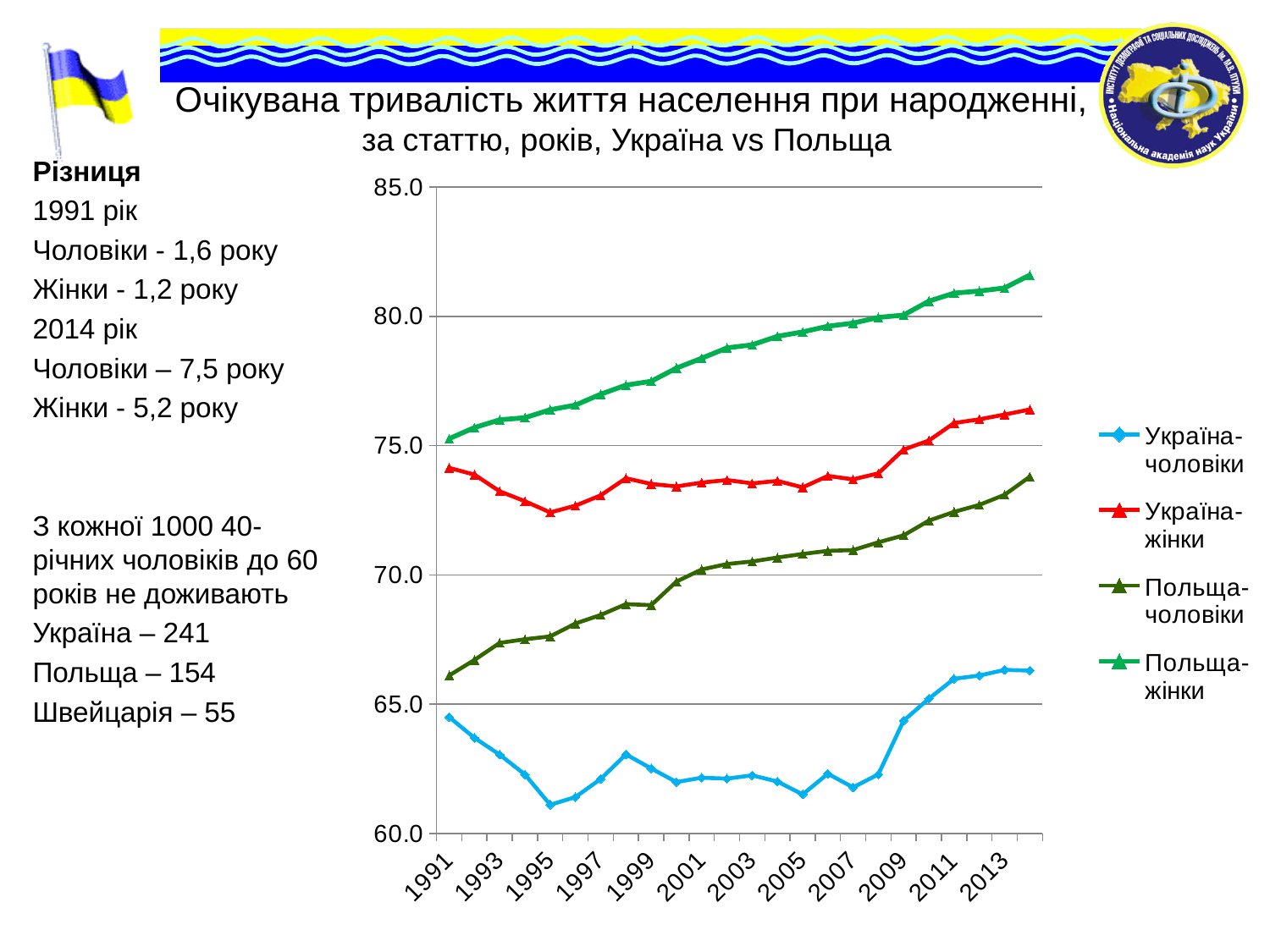
Is the value for Польща-жінки in 2013 greater or less than 80.0? greater Is the value for Україна-чоловіки in 1995 greater or less than 65.0? less Which series has the highest values throughout the chart? Польща-жінки Which series has the lowest values throughout the chart? Україна-чоловіки How many year labels are shown on the x axis? 12 In 2005, which is larger: the value for Україна-чоловіки or for Польща-чоловіки? Польща-чоловіки Does the Польща-жінки series rise or fall from 1991 to 2014? rise What is the first legend entry of the chart? Україна-чоловіки What kind of chart is shown on the slide? line chart How many series does the legend list? 4 Is the value for Україна-жінки in 1991 greater or less than 75.0? less